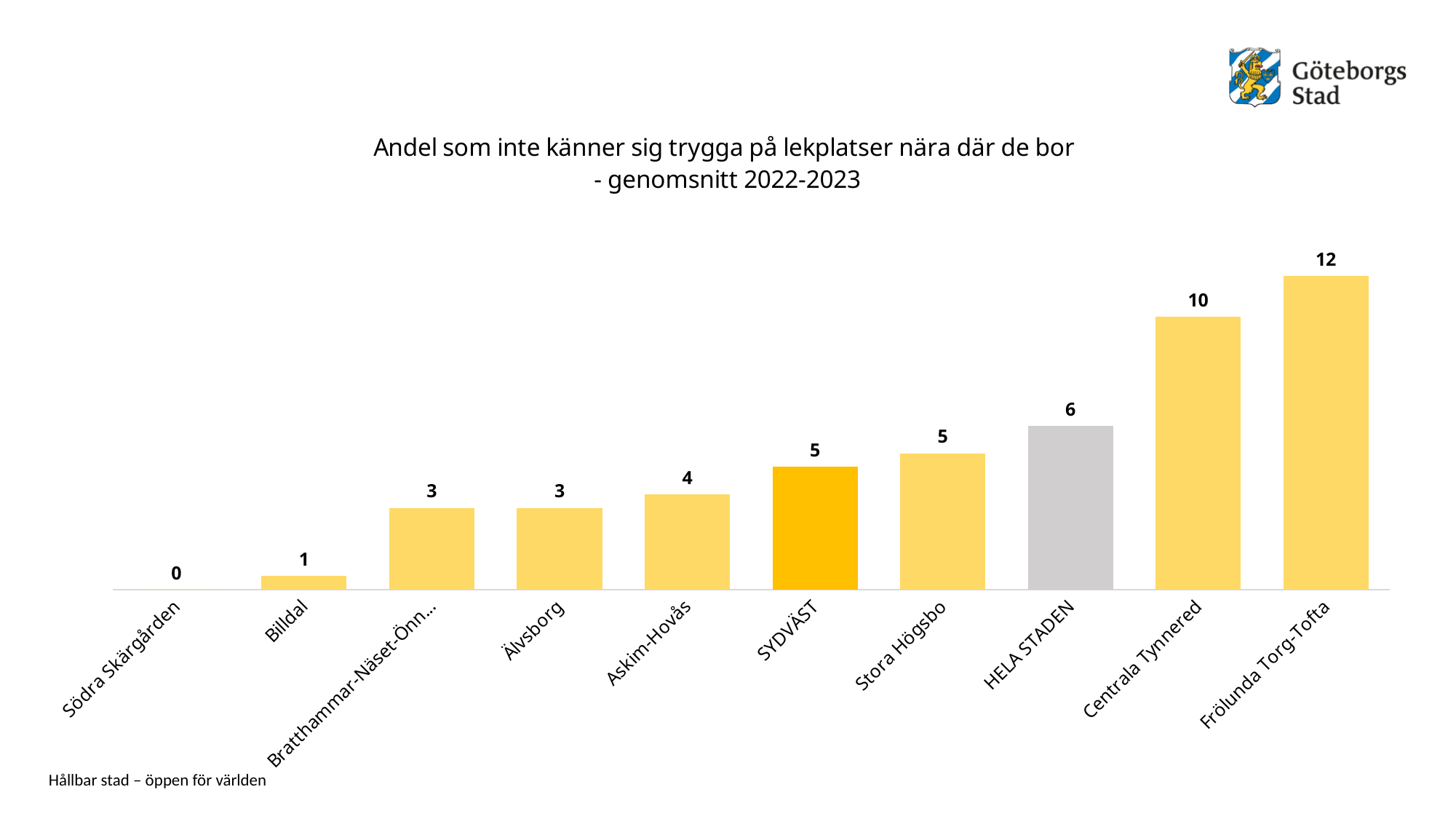
Which category has the lowest value? Södra Skärgården Do the values rise or fall from left to right along the x axis? Rise Which is larger, the value for Centrala Tynnered or the value for Stora Högsbo? Centrala Tynnered What is the value for SYDVÄST? 5 What is the value for Frölunda Torg-Tofta? 12 What is the difference between the values for Frölunda Torg-Tofta and Centrala Tynnered? 2 What is the value for HELA STADEN? 6 Which category has the highest value? Frölunda Torg-Tofta What kind of chart is shown on the slide? Bar chart How many categories are shown on the x axis? 10 What is the difference between the values for HELA STADEN and Askim-Hovås? 2 What is the value for Billdal? 1